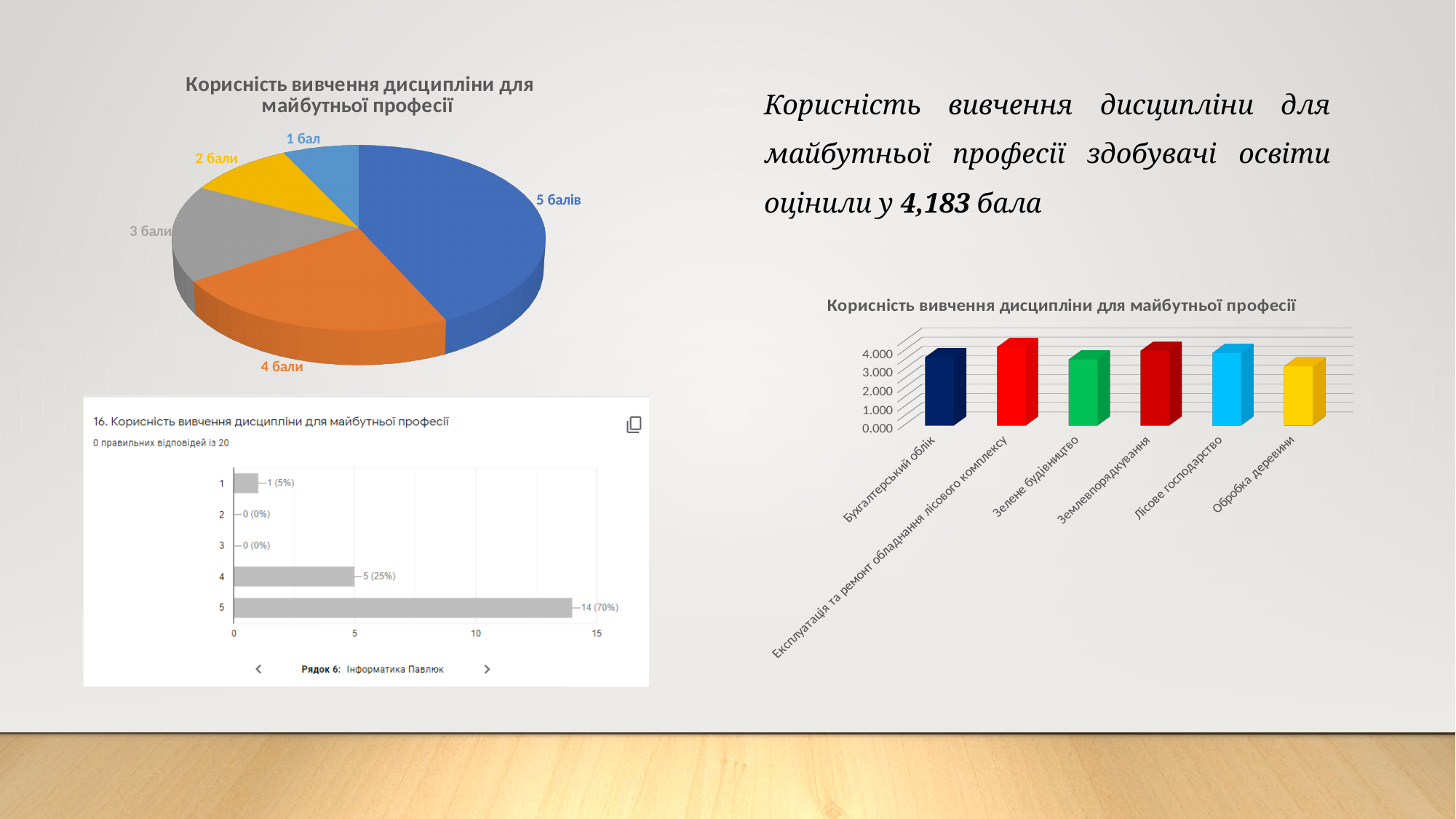
In the bottom-left bar chart (question 16), how many rating categories are shown? 5 In the pie chart at the top left, which slice is larger: 4 бали or 2 бали? 4 бали In the bottom-left bar chart (question 16), what is the difference between the counts for rating 5 and rating 4? 9 In the pie chart at the top left, which category has the largest slice? 5 балів In the pie chart at the top left, how many slices are there? 5 In the bottom-left bar chart (question 16), what kind of chart is it? bar chart In the bottom-left bar chart (question 16), what is the value shown for rating 4? 5 (25%) In the bar chart on the right, is the value for Обробка деревини greater or less than 2.000? greater In the bottom-left bar chart (question 16), what is the value shown for rating 5? 14 (70%) In the bottom-left bar chart (question 16), which rating has the highest count? 5 In the bottom-left bar chart (question 16), what is the value shown for rating 1? 1 (5%) In the bar chart on the right, which category has the highest bar? Експлуатація та ремонт обладнання лісового комплексу